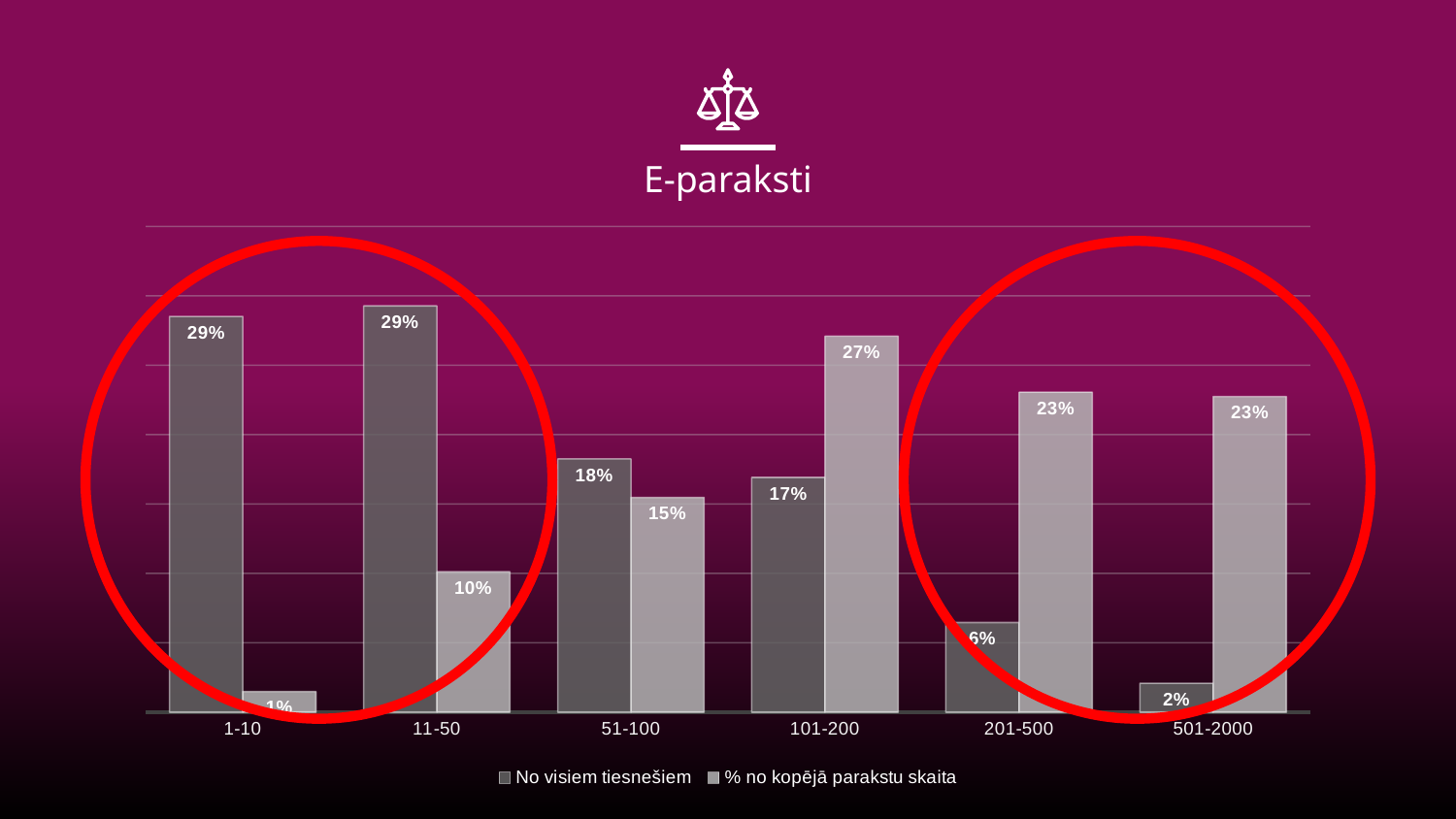
Which category has the highest value in the "% no kopējā parakstu skaita" series? 101-200 How many series does the legend list? 2 What is the difference between the two series for the 11-50 category? 19% What is the value for 101-200 in the "% no kopējā parakstu skaita" series? 27% How many categories are shown on the x axis? 6 Which category has the lowest value in the "No visiem tiesnešiem" series? 501-2000 What is the value for 201-500 in the "No visiem tiesnešiem" series? 6% What is the title of the chart? E-paraksti What is the value for 1-10 in the "% no kopējā parakstu skaita" series? 1% What is the value for 51-100 in the "No visiem tiesnešiem" series? 18% For the 201-500 category, which series has the larger value? % no kopējā parakstu skaita What kind of chart is shown on the slide? Bar chart